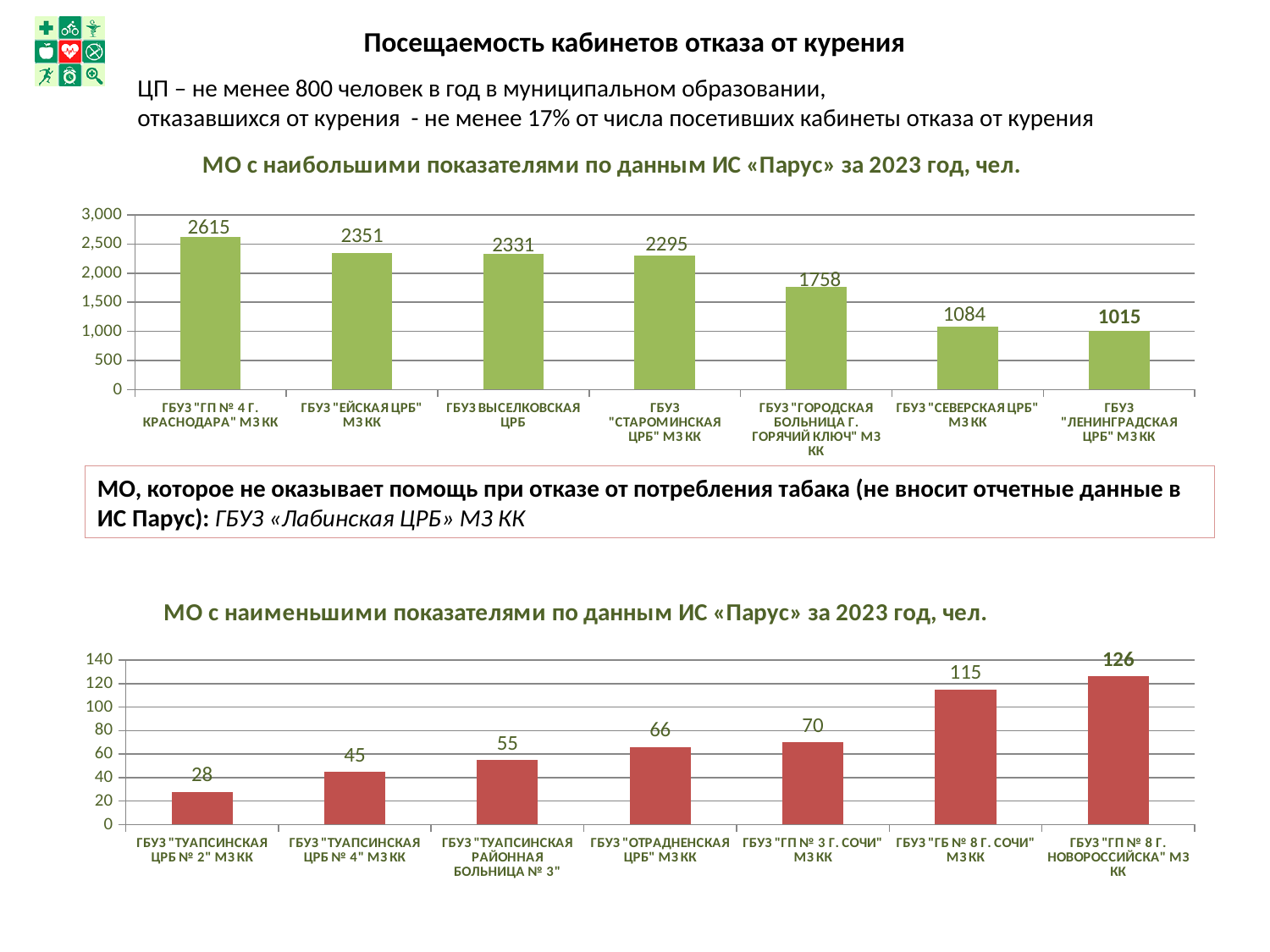
In the top chart (МО с наибольшими показателями), what is the value for ГБУЗ "ГП № 4 г. Краснодара" МЗ КК? 2615 In the top chart (МО с наибольшими показателями), what is the value for ГБУЗ "Городская больница г. Горячий Ключ" МЗ КК? 1758 In the bottom chart (МО с наименьшими показателями), do the values rise or fall from left to right? rise In the bottom chart (МО с наименьшими показателями), what is the value for ГБУЗ "Отрадненская ЦРБ" МЗ КК? 66 In the bottom chart (МО с наименьшими показателями), which is larger: the value for ГБУЗ "ГП № 3 г. Сочи" МЗ КК or ГБУЗ "Туапсинская ЦРБ № 4" МЗ КК? ГБУЗ "ГП № 3 г. Сочи" МЗ КК In the top chart (МО с наибольшими показателями), what is the difference between the values for ГБУЗ "Ейская ЦРБ" МЗ КК and ГБУЗ "Северская ЦРБ" МЗ КК? 1267 In the top chart (МО с наибольшими показателями), do the values rise or fall from left to right? fall In the top chart (МО с наибольшими показателями), which category has the lowest value? ГБУЗ "Ленинградская ЦРБ" МЗ КК In the bottom chart (МО с наименьшими показателями), which category has the highest value? ГБУЗ "ГП № 8 г. Новороссийска" МЗ КК In the bottom chart (МО с наименьшими показателями), what is the difference between the values for ГБУЗ "ГБ № 8 г. Сочи" МЗ КК and ГБУЗ "Туапсинская ЦРБ № 2" МЗ КК? 87 In the top chart (МО с наибольшими показателями), how many categories are plotted? 7 What type of chart is the bottom chart (МО с наименьшими показателями)? bar chart